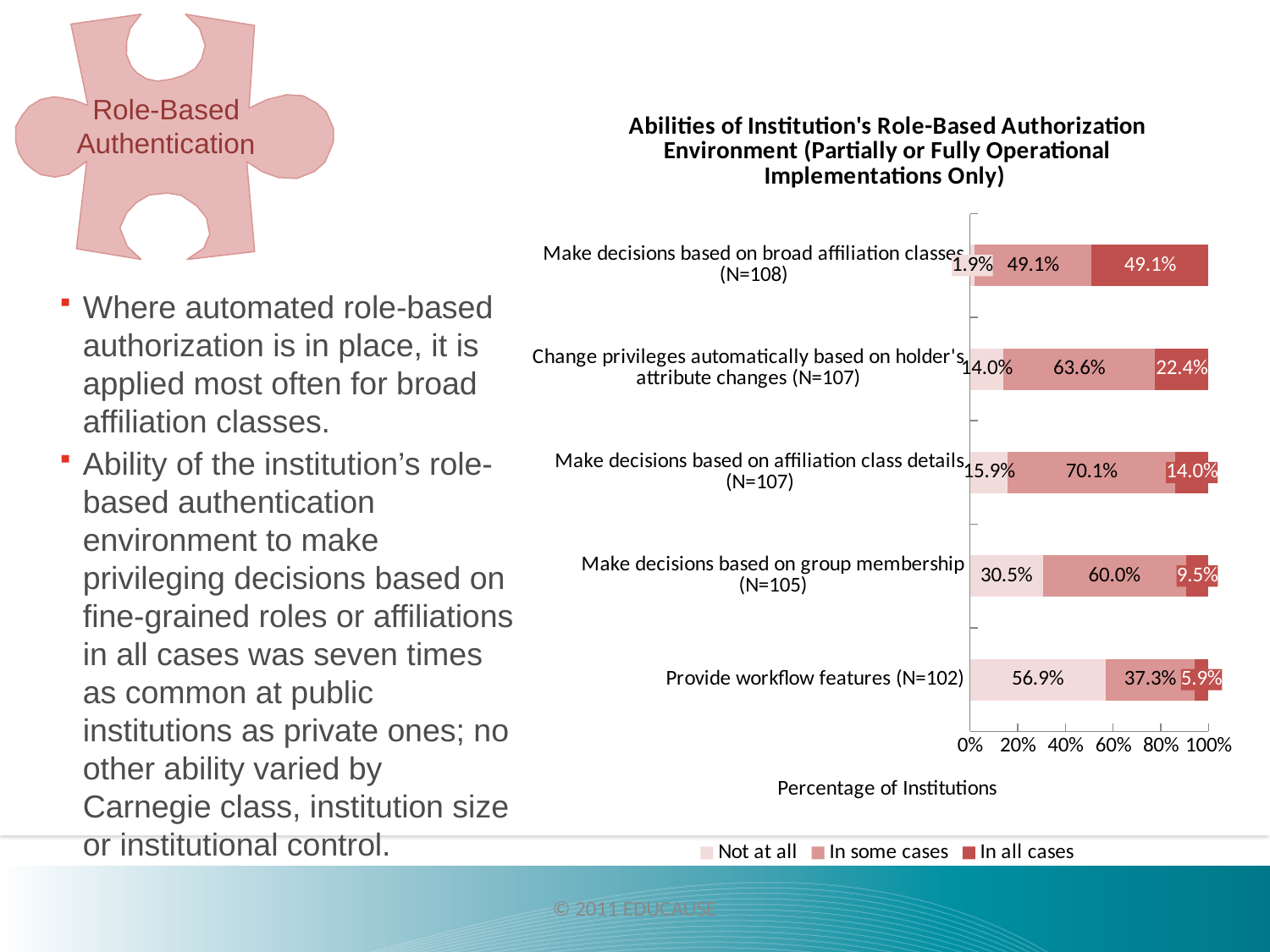
What is the 'In some cases' value for 'Make decisions based on affiliation class details (N=107)'? 70.1% What percentage of institutions reported 'In all cases' for 'Make decisions based on broad affiliation classes (N=108)'? 49.1% What is the difference between the 'In some cases' values for 'Make decisions based on affiliation class details (N=107)' and 'Make decisions based on group membership (N=105)'? 10.1% How many categories are shown on the chart? 5 Which category has the highest 'Not at all' value? Provide workflow features (N=102) How many series does the legend list? 3 What is the 'In all cases' value for 'Change privileges automatically based on holder's attribute changes (N=107)'? 22.4% What is the label of the horizontal axis? Percentage of Institutions Which is larger: the 'Not at all' value for 'Make decisions based on group membership (N=105)' or for 'Make decisions based on affiliation class details (N=107)'? Make decisions based on group membership (N=105) Which category has the lowest 'In all cases' value? Provide workflow features (N=102) What kind of chart is shown on the slide? Stacked bar chart What is the 'Not at all' value for 'Provide workflow features (N=102)'? 56.9%